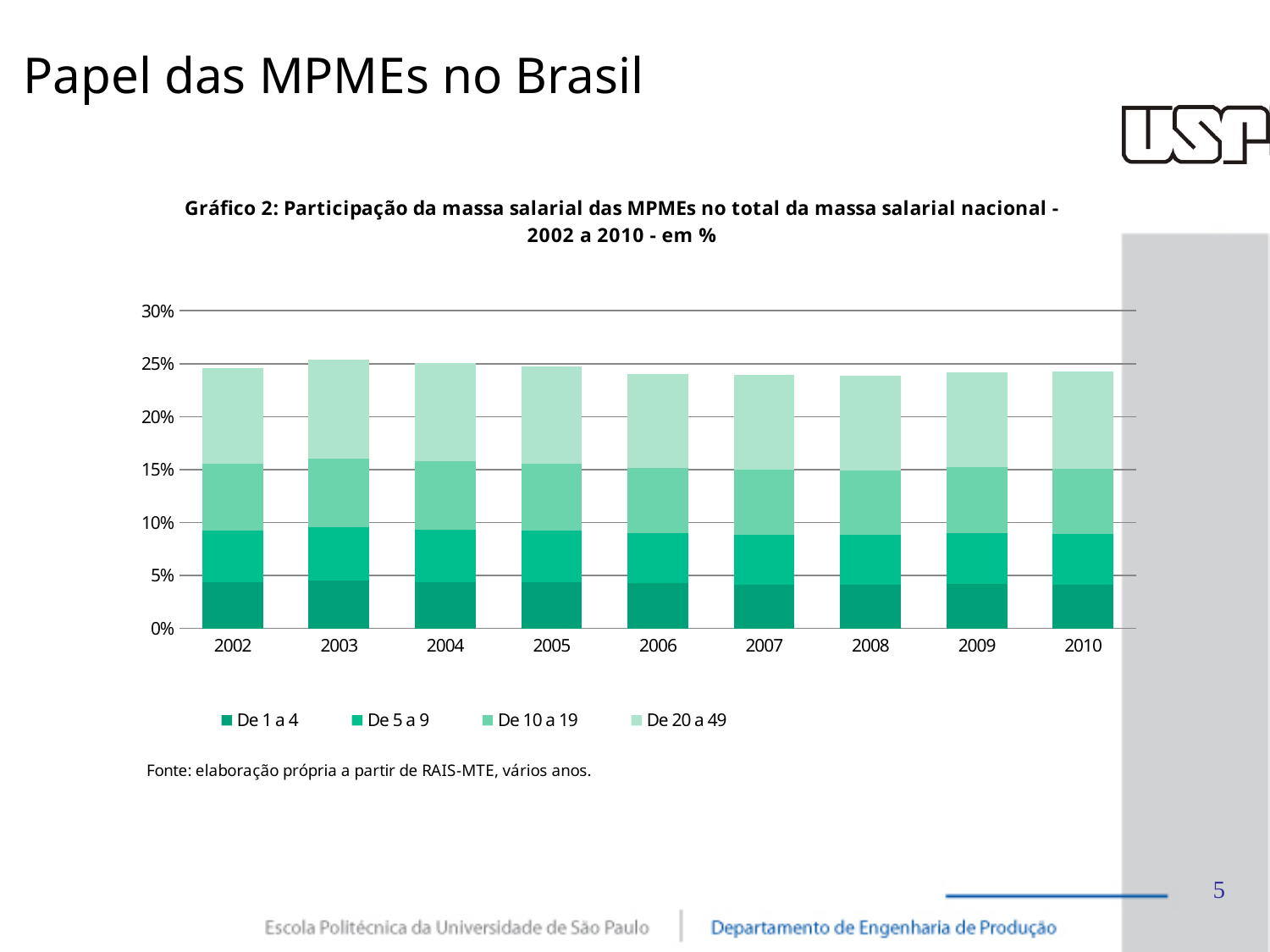
What kind of chart is shown on the slide? stacked bar chart Which year has the larger total stacked value, 2003 or 2008? 2003 What is the last series listed in the chart's legend? De 20 a 49 How many series does the chart's legend list? 4 Is the total stacked value for 2003 greater or less than 25%? greater How many years are shown on the x axis of the chart? 9 What is the first series listed in the chart's legend? De 1 a 4 Is the total stacked value for 2010 greater or less than 30%? less Is the total stacked value for 2002 greater or less than 20%? greater